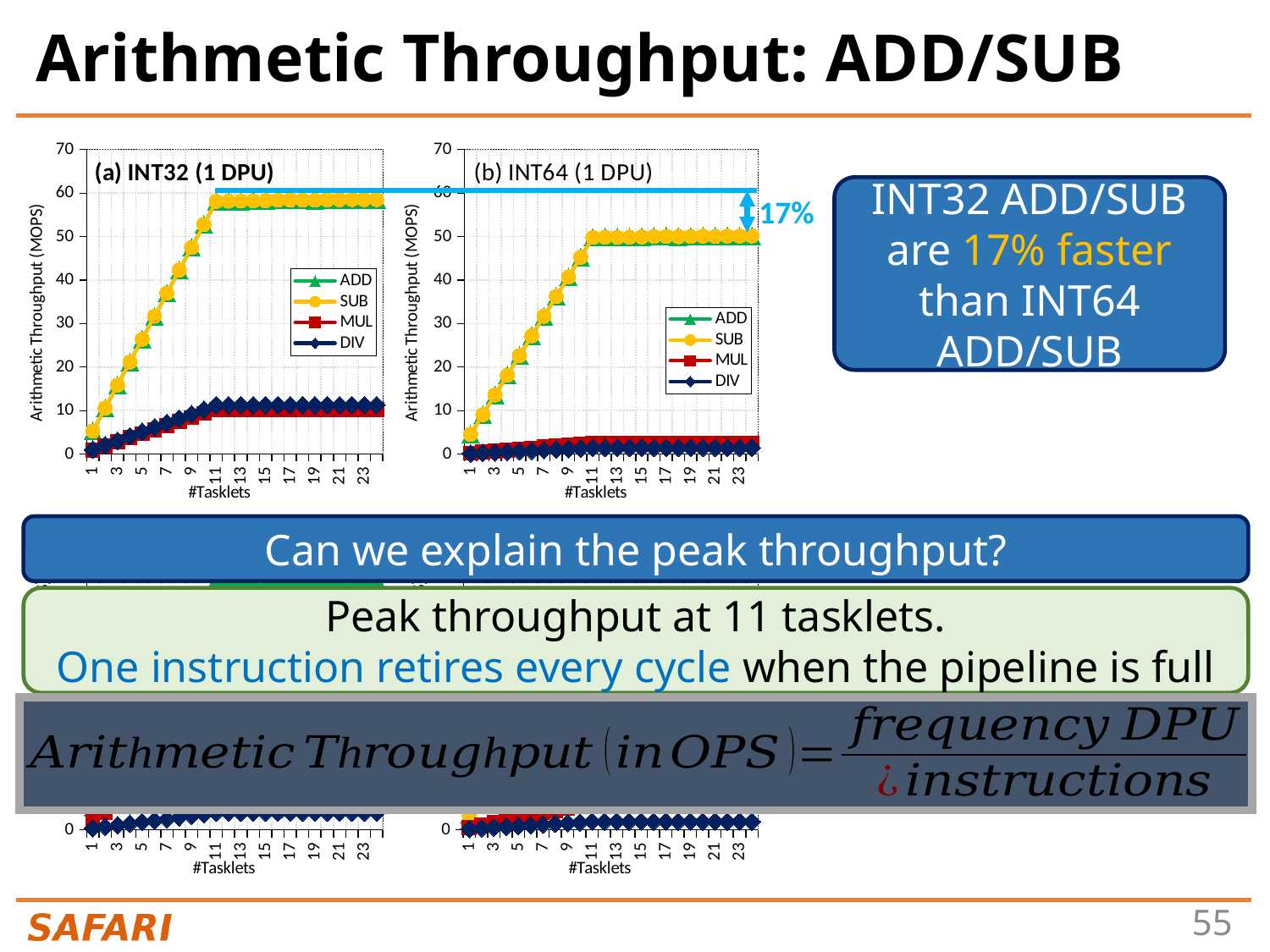
Which chart reaches a higher peak ADD throughput: (a) INT32 (1 DPU) or (b) INT64 (1 DPU)? (a) INT32 (1 DPU) What kind of chart is chart (a) INT32 (1 DPU)? line chart In chart (b) INT64 (1 DPU), is the ADD value at 23 tasklets greater or less than 60? less In chart (b) INT64 (1 DPU), is the MUL value at 23 tasklets greater or less than 10? less In chart (a) INT32 (1 DPU), does the ADD series rise or fall as the number of tasklets increases from 1 to 11? rise Which series are listed in the legend of chart (b) INT64 (1 DPU)? ADD, SUB, MUL, DIV How many series does the legend of chart (a) INT32 (1 DPU) list? 4 In chart (a) INT32 (1 DPU), at 23 tasklets, which is larger: ADD or DIV? ADD In chart (a) INT32 (1 DPU), is the ADD value at 23 tasklets greater or less than 50? greater In chart (b) INT64 (1 DPU), does the SUB series rise or fall between 1 and 11 tasklets? rise What percentage difference is annotated between the peak throughputs of chart (a) and chart (b)? 17%